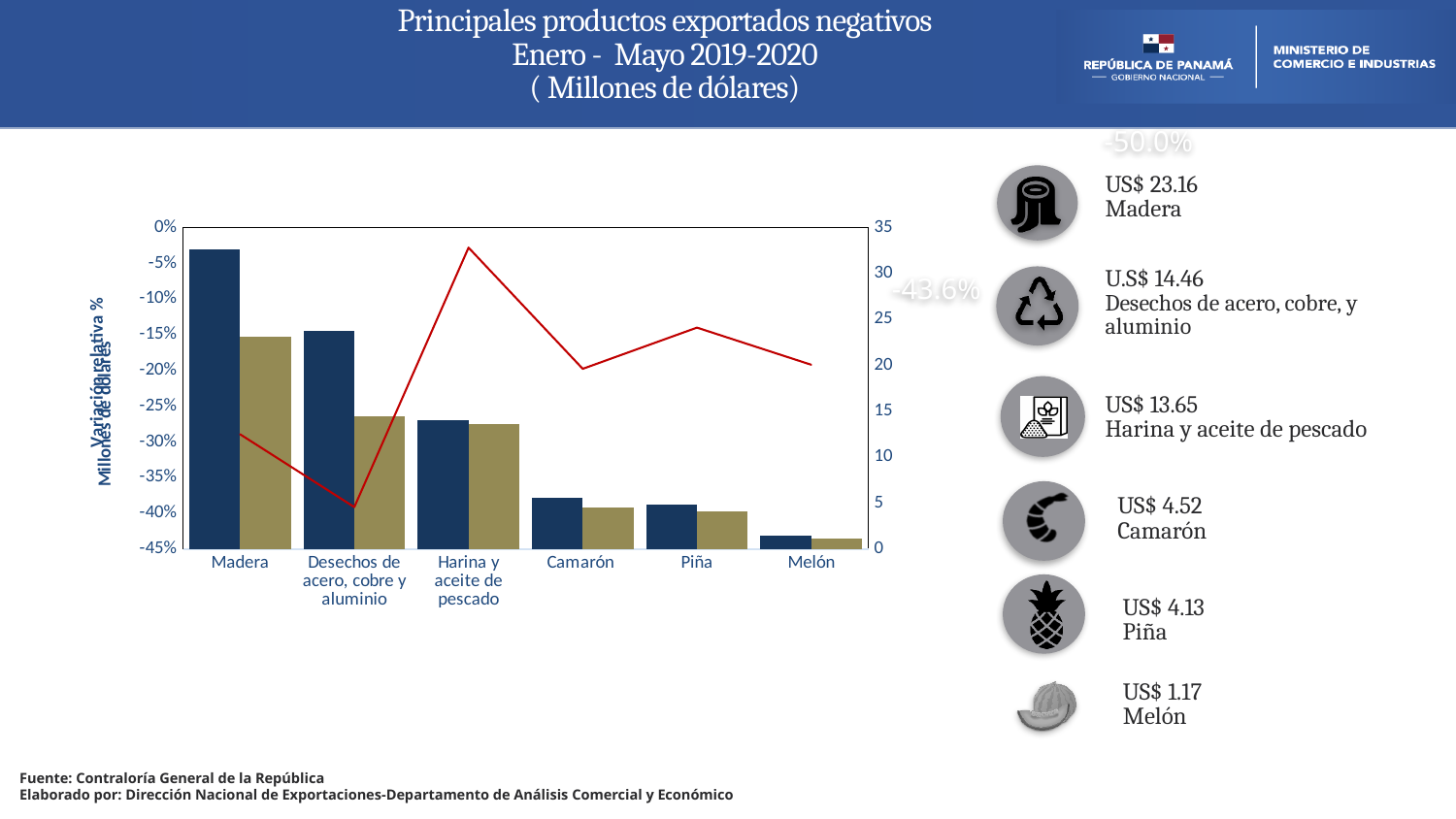
Which category has the shortest bars? Melón Is the olive bar for Madera greater or less than 20 on the right axis? greater Is the red line value for Desechos de acero, cobre y aluminio greater or less than -35%? less Which category has the highest point on the red line? Harina y aceite de pescado How many product categories are shown on the x axis of the chart? 6 Which dark blue bar is taller, Madera or Desechos de acero, cobre y aluminio? Madera Is the dark blue bar for Madera greater or less than 30 on the right axis? greater Do the bar heights generally rise or fall from left to right across the categories? fall Which category has the lowest point on the red line? Desechos de acero, cobre y aluminio What kind of chart is shown on the slide? A bar chart combined with a line Which category has the tallest dark blue bar? Madera